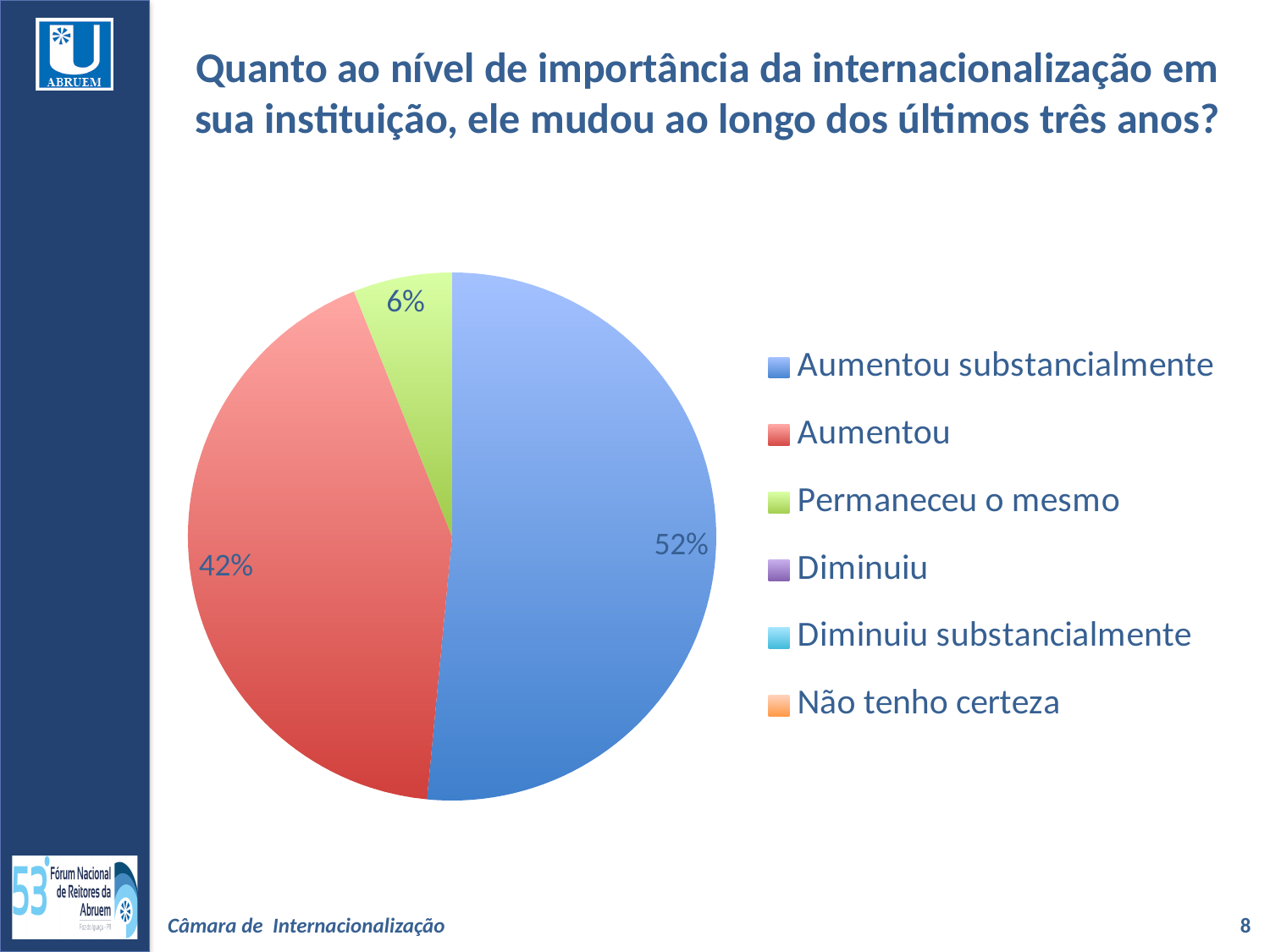
What is the difference in percentage points between "Aumentou substancialmente" and "Aumentou"? 10 What share of the pie does "Permaneceu o mesmo" represent? 6% How many entries does the legend list? 6 How many slices with data labels are visible in the pie? 3 What is the difference in percentage points between "Aumentou" and "Permaneceu o mesmo"? 36 Which category has the largest slice of the pie? Aumentou substancialmente Which of the visible slices is the smallest? Permaneceu o mesmo What share of the pie does "Aumentou substancialmente" represent? 52% What kind of chart is shown on the slide? pie chart What colour is the slice for "Aumentou"? red Which is larger, the slice for "Aumentou substancialmente" or the slice for "Aumentou"? Aumentou substancialmente What share of the pie does "Aumentou" represent? 42%